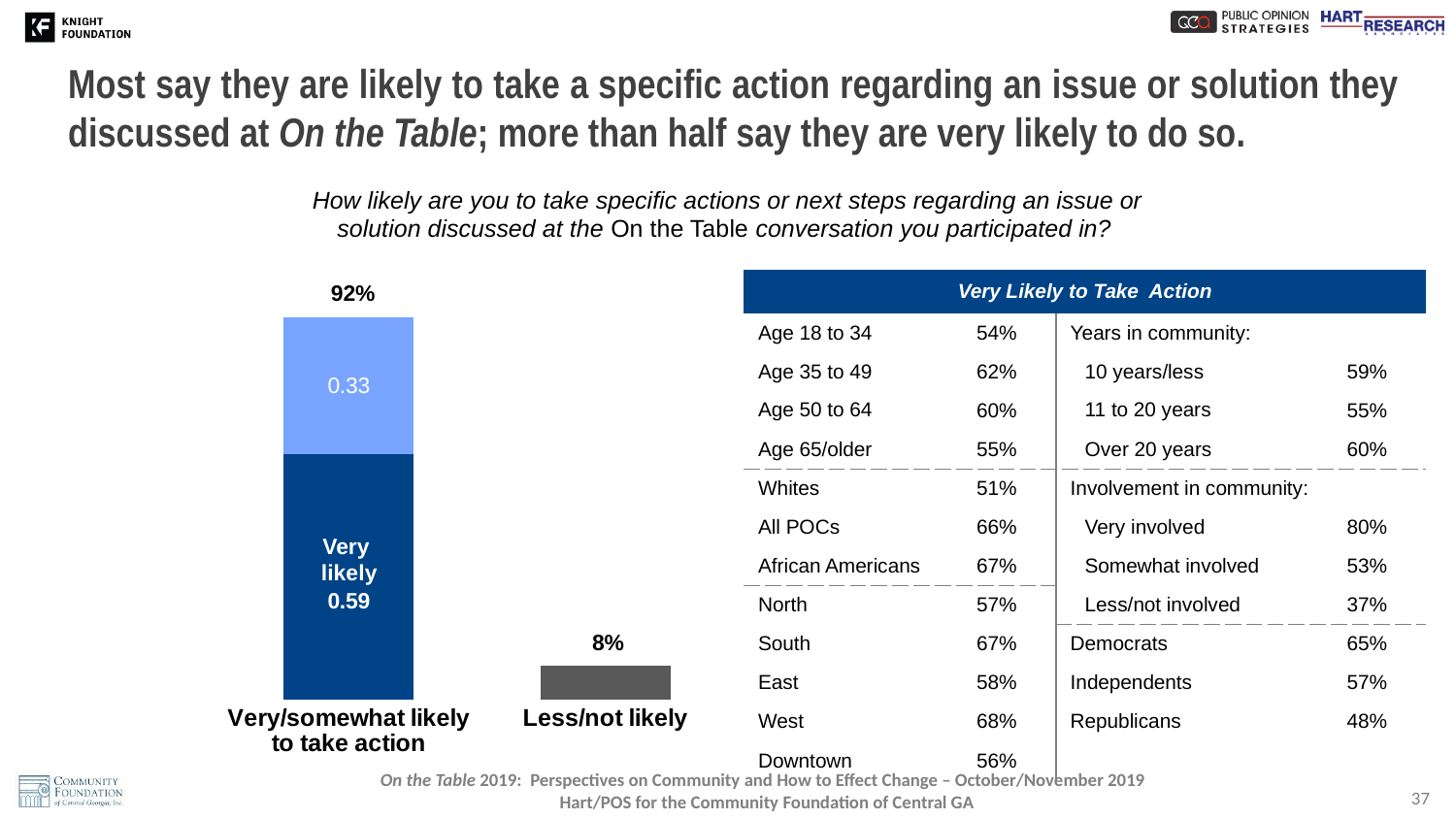
What kind of chart is shown on the slide? bar chart What is the label of the category on the left side of the chart? Very/somewhat likely to take action What value is printed on the 'Very likely' segment of the stacked bar? 0.59 What is the total value shown above the 'Very/somewhat likely to take action' bar? 92% Which bar is taller, 'Very/somewhat likely to take action' or 'Less/not likely'? Very/somewhat likely to take action What is the difference between the 'Very/somewhat likely to take action' total (92%) and the 'Less/not likely' value (8%)? 84 percentage points What value is printed on the upper (lighter blue) segment of the 'Very/somewhat likely to take action' bar? 0.33 Which category has the lowest value in the chart? Less/not likely How many bars are shown in the chart? 2 What is the value shown for 'Less/not likely'? 8% What colour is the 'Very likely' segment of the stacked bar? dark blue Which segment of the stacked bar is larger, the 'Very likely' segment (0.59) or the upper segment (0.33)? Very likely